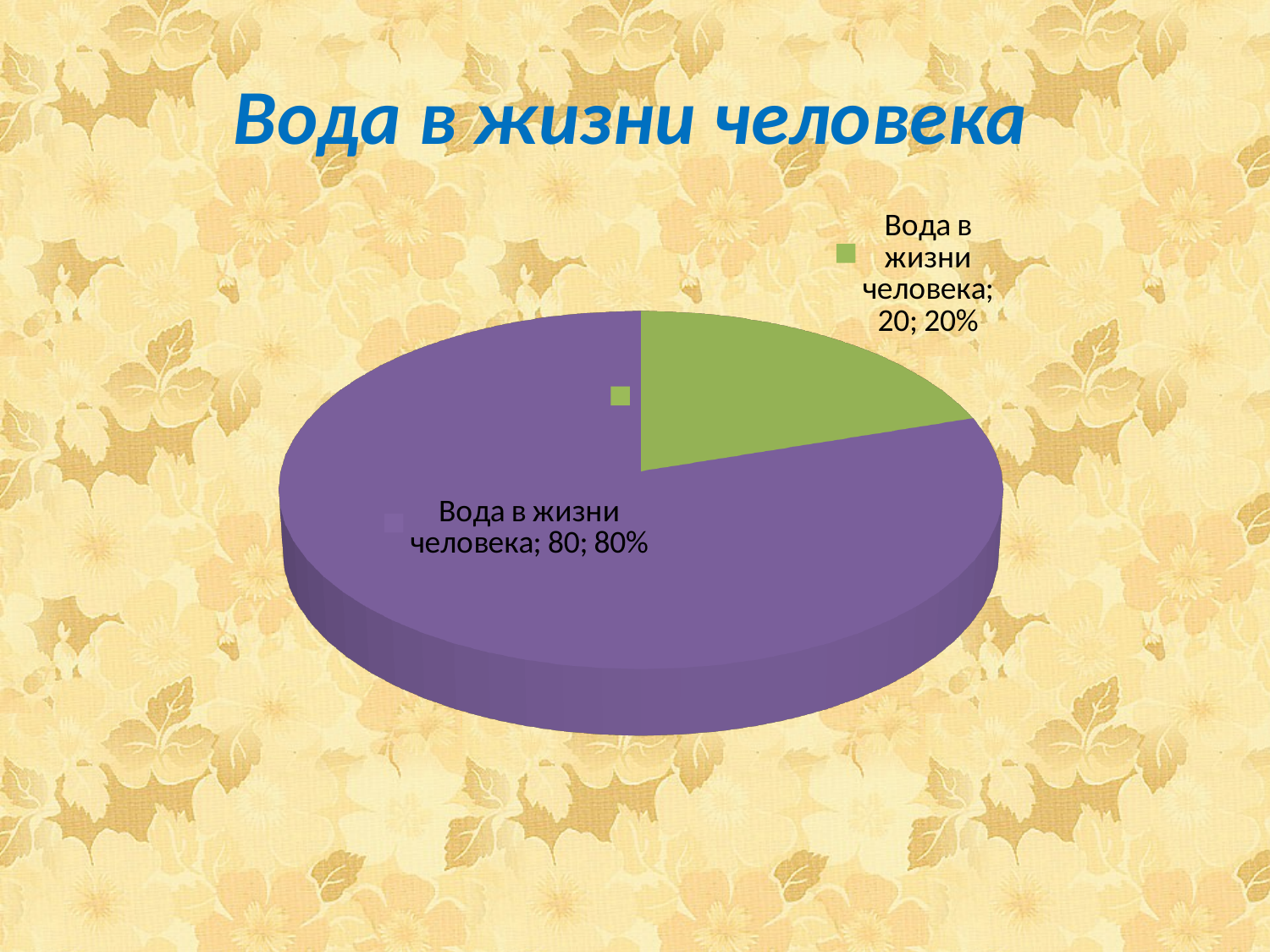
What percentage share does the purple slice of the pie chart represent? 80% What is the difference between the values of the purple slice and the green slice in the pie chart? 60 How many slices does the pie chart have? 2 Which slice of the pie chart is the largest, the purple one or the green one? the purple one What value is printed on the green slice of the pie chart? 20 What kind of chart is shown on the slide? pie chart What value is printed on the purple slice of the pie chart? 80 What percentage share does the green slice of the pie chart represent? 20% What is the title of the slide containing the pie chart? Вода в жизни человека Is the value of the green slice larger or smaller than the value of the purple slice? smaller What is the total of the two values shown in the pie chart? 100 Which slice of the pie chart is the smallest, the purple one or the green one? the green one